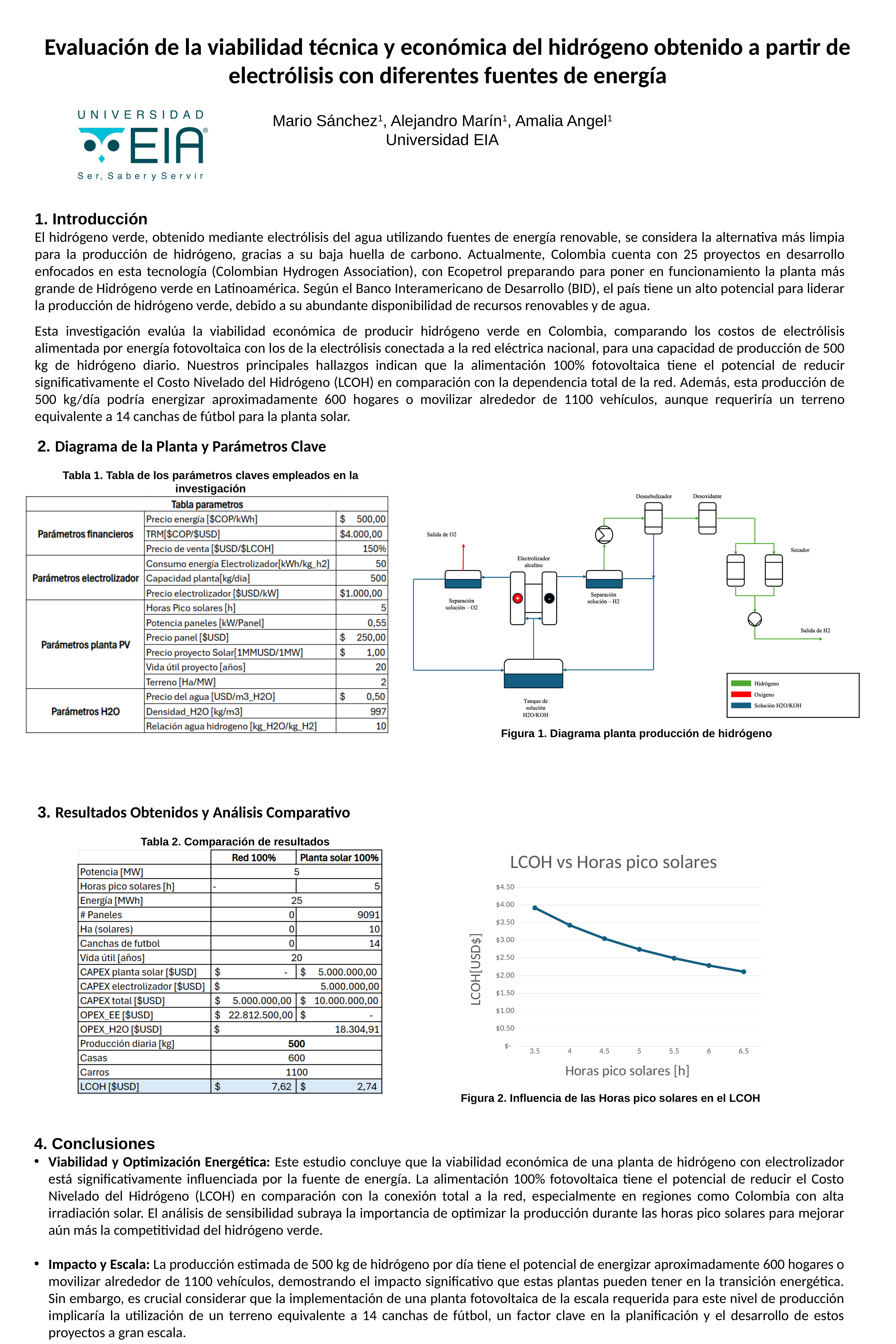
What is the label of the x axis in the chart "LCOH vs Horas pico solares"? Horas pico solares [h] In the chart "LCOH vs Horas pico solares", how many data points are plotted? 7 What kind of chart is "LCOH vs Horas pico solares"? line chart In the chart "LCOH vs Horas pico solares", is the LCOH at 4 peak solar hours greater or less than $3.00? greater In the chart "LCOH vs Horas pico solares", which has the larger LCOH: 4 peak solar hours or 6 peak solar hours? 4 In the chart "LCOH vs Horas pico solares", is the LCOH at 5 peak solar hours greater or less than $3.00? less In the chart "LCOH vs Horas pico solares", is the LCOH at 3.5 peak solar hours greater or less than $3.50? greater What is the label of the y axis in the chart "LCOH vs Horas pico solares"? LCOH[USD$] In the chart "LCOH vs Horas pico solares", at which value of Horas pico solares is the LCOH highest? 3.5 In the chart "LCOH vs Horas pico solares", do the values rise or fall as the peak solar hours increase along the x axis? fall In the chart "LCOH vs Horas pico solares", at which value of Horas pico solares is the LCOH lowest? 6.5